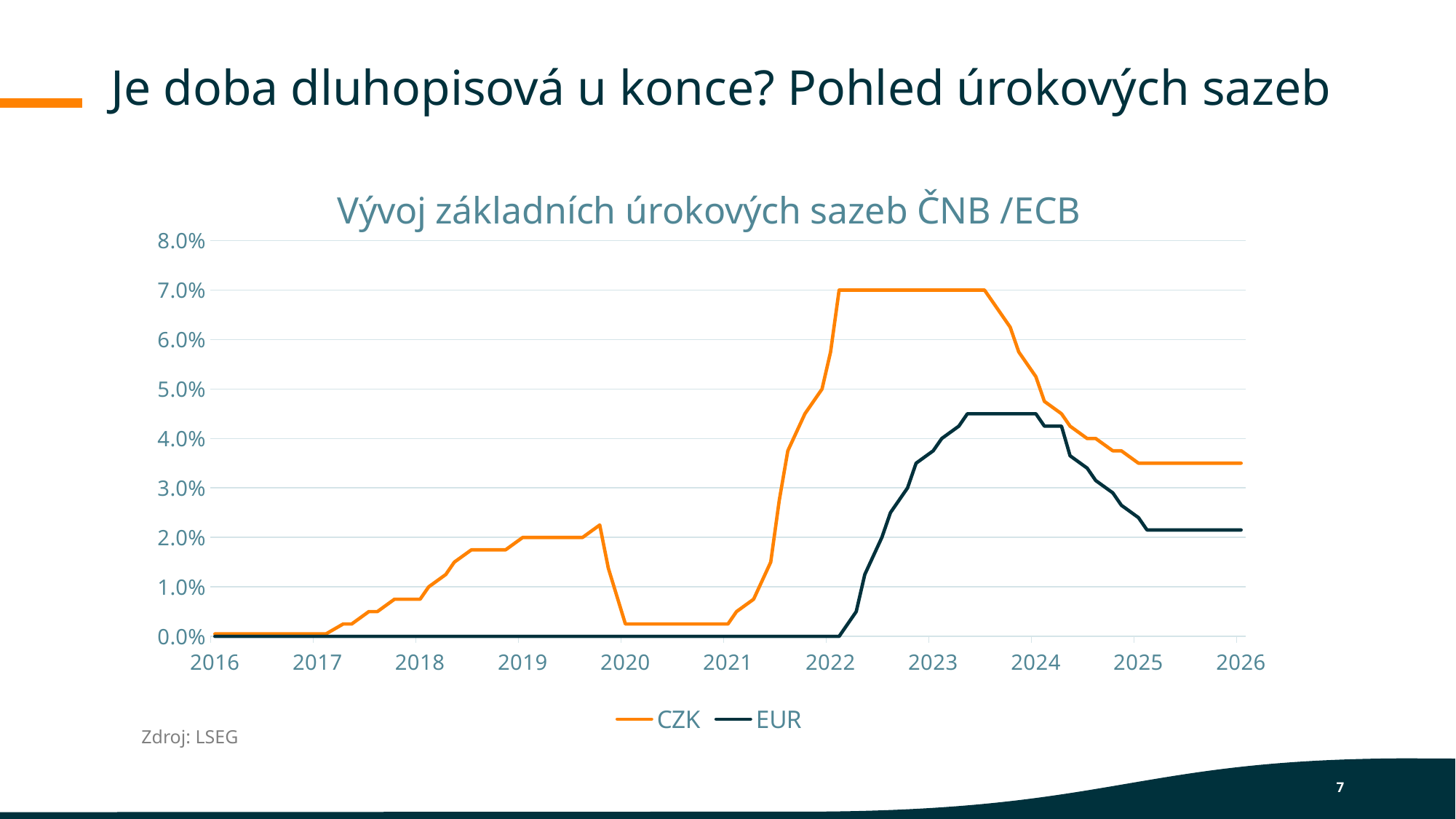
Is the peak value of the EUR series greater or less than 4.0%? greater At 2026, which series has the higher value, CZK or EUR? CZK Is the EUR value at 2026 greater or less than 3.0%? less What are the two series named in the legend? CZK and EUR Does the CZK series rise or fall between 2023 and 2025? fall Which series reaches the higher peak, CZK or EUR? CZK Is the CZK value at 2026 greater or less than 3.0%? greater How many series does the legend list? 2 What is the highest value reached by the CZK series? 7.0% What is the value of the EUR series at 2016? 0.0% What is the title of the chart? Vývoj základních úrokových sazeb ČNB /ECB What kind of chart is shown on the slide? line chart